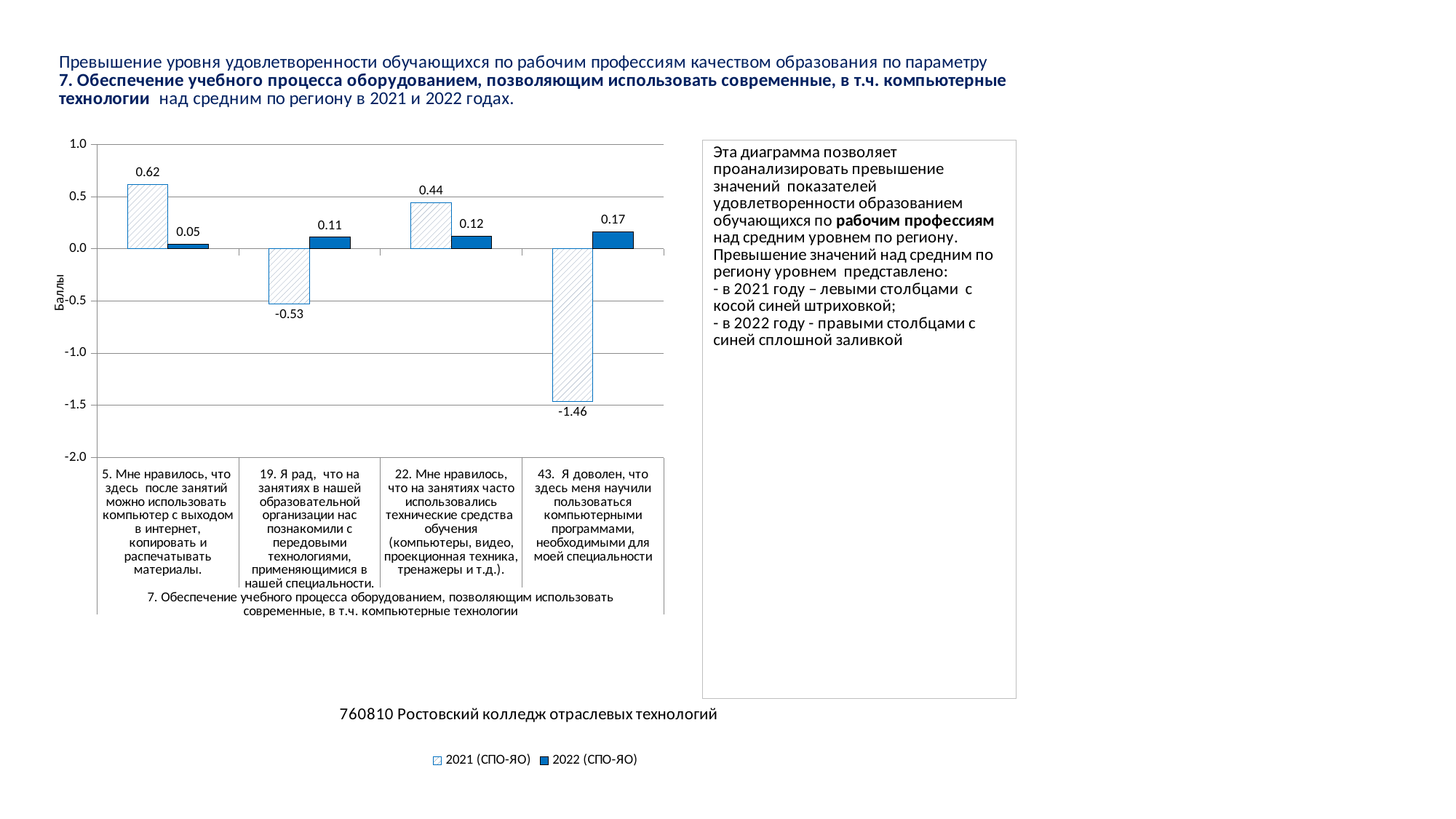
What type of chart is shown on the slide? Bar chart Which category has the lowest 2021 (СПО-ЯО) value? 43. Я доволен, что здесь меня научили пользоваться компьютерными программами, необходимыми для моей специальности What is the difference between the 2021 and 2022 values for category 5? 0.57 For category 22, which is larger: the 2021 value or the 2022 value? 2021 (0.44) What is the 2021 (СПО-ЯО) value for category 5 ("Мне нравилось, что здесь после занятий можно использовать компьютер...")? 0.62 Which category has the highest 2022 (СПО-ЯО) value? 43. Я доволен, что здесь меня научили пользоваться компьютерными программами, необходимыми для моей специальности What is the 2021 (СПО-ЯО) value for category 19 ("Я рад, что на занятиях в нашей образовательной организации нас познакомили с передовыми технологиями...")? -0.53 Which category has the highest 2021 (СПО-ЯО) value? 5. Мне нравилось, что здесь после занятий можно использовать компьютер с выходом в интернет, копировать и распечатывать материалы. How many series does the legend list? 2 What is the difference between the 2022 values for category 43 and category 5? 0.12 What is the 2022 (СПО-ЯО) value for category 43 ("Я доволен, что здесь меня научили пользоваться компьютерными программами...")? 0.17 How many categories are shown on the x axis of the chart? 4